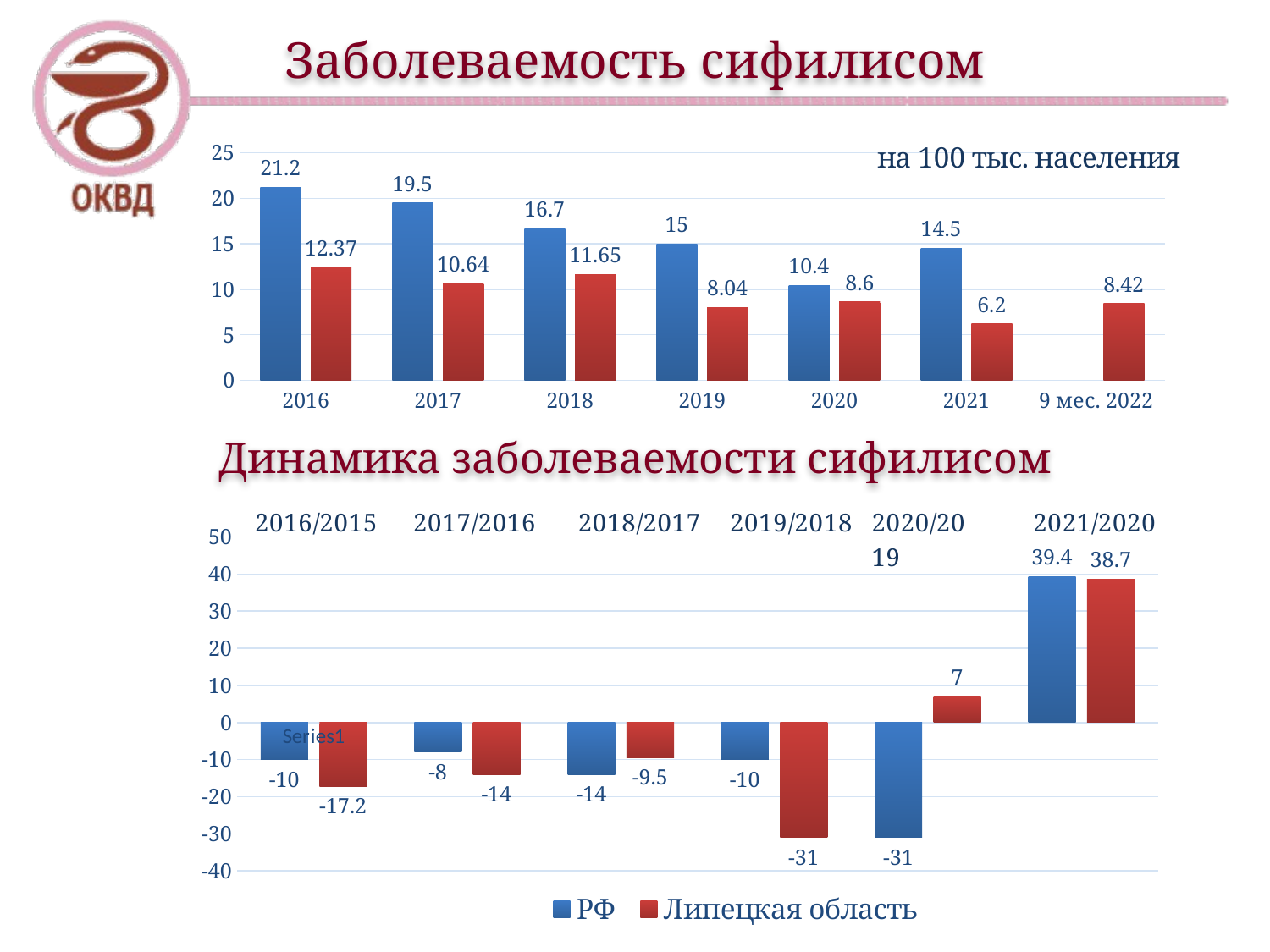
In the top chart 'Заболеваемость сифилисом', what is the difference between the blue and red bars for 2021? 8.3 In the top chart 'Заболеваемость сифилисом', what is the value of the blue bar for 2016? 21.2 In the bottom chart 'Динамика заболеваемости сифилисом', which is larger in 2021/2020: РФ or Липецкая область? РФ In the bottom chart 'Динамика заболеваемости сифилисом', what is the value for Липецкая область in 2016/2015? -17.2 In the bottom chart 'Динамика заболеваемости сифилисом', how many series does the legend list? 2 In the top chart 'Заболеваемость сифилисом', which year has the lowest red bar? 2021 In the top chart 'Заболеваемость сифилисом', how many categories are shown on the x axis? 7 In the top chart 'Заболеваемость сифилисом', what is the value shown for '9 мес. 2022'? 8.42 In the bottom chart 'Динамика заболеваемости сифилисом', what is the value for РФ in 2020/2019? -31 What type of chart is the bottom chart 'Динамика заболеваемости сифилисом'? Bar chart In the top chart 'Заболеваемость сифилисом', what is the value of the red bar for 2018? 11.65 In the top chart 'Заболеваемость сифилисом', which year has the highest blue bar? 2016